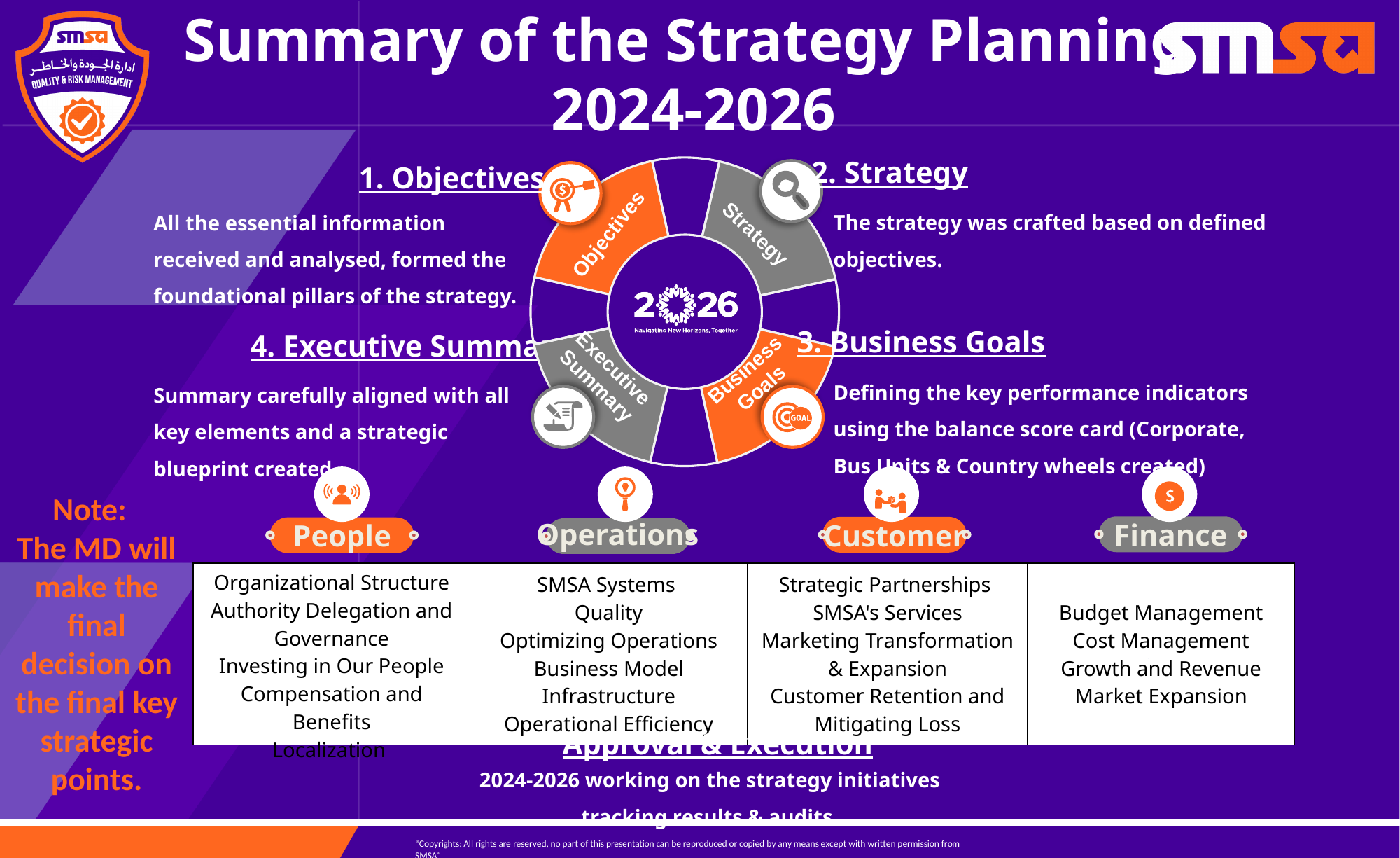
Which segments of the circular wheel diagram are coloured orange? Objectives and Business Goals What are the four segment labels on the circular wheel diagram? Objectives, Strategy, Business Goals, Executive Summary What year is shown in the centre of the circular wheel diagram? 2026 How many segments does the circular wheel diagram in the centre of the slide have? 4